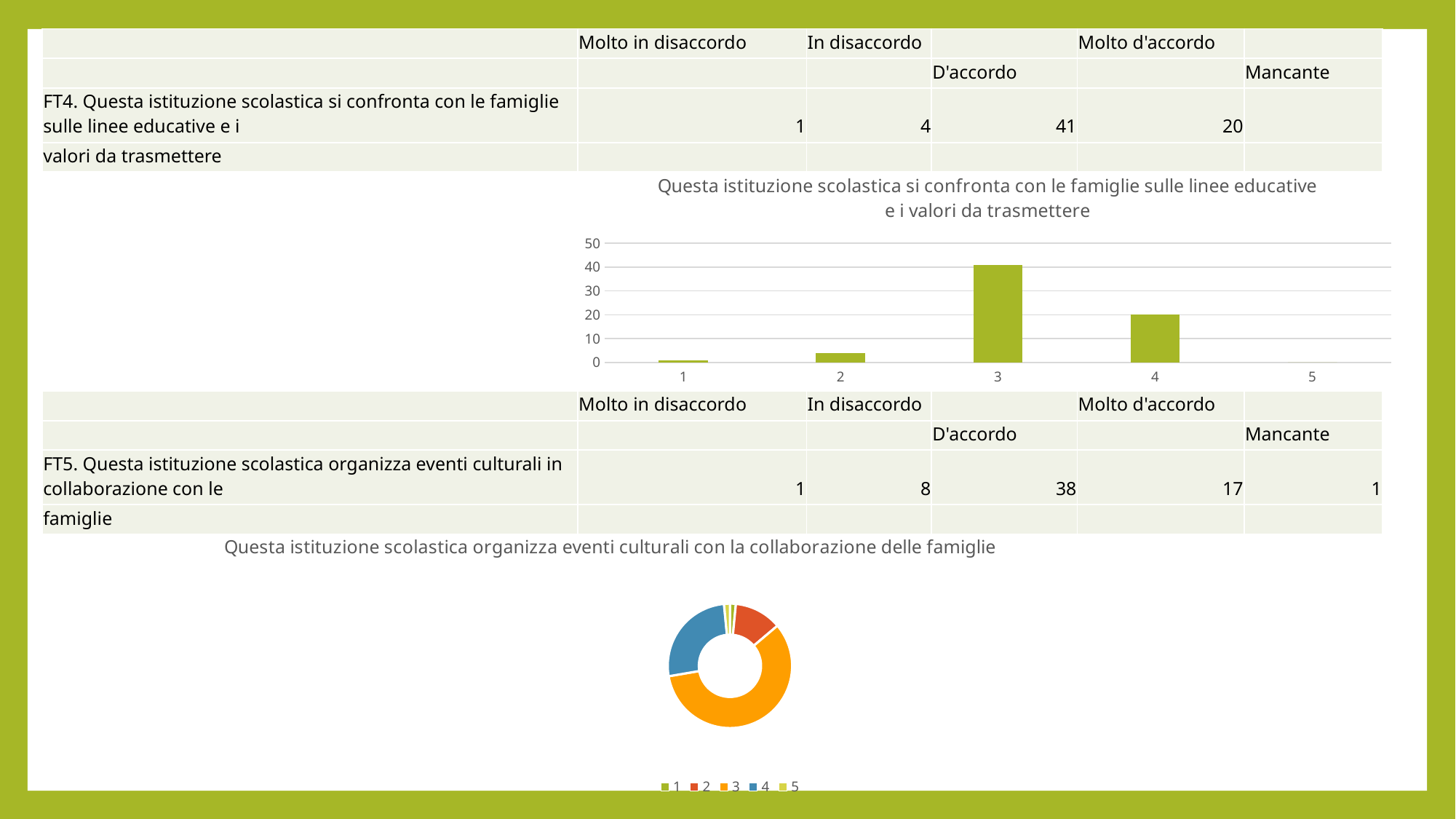
In the top bar chart, what is the highest value shown on the vertical axis? 50 In the bottom doughnut chart, how many entries does the legend list? 5 In the top bar chart, is the value for category 2 greater or less than 10? less In the bottom doughnut chart, which slice is larger, category 2 or category 4? category 4 In the top bar chart, what is the value for category 4? 20 In the top bar chart, which category has the highest bar? 3 In the top bar chart, which is larger, the bar for category 2 or the bar for category 4? category 4 In the top bar chart, how many categories are shown on the x axis? 5 In the bottom doughnut chart, which category has the largest slice? 3 What kind of chart is the bottom chart titled "Questa istituzione scolastica organizza eventi culturali con la collaborazione delle famiglie"? doughnut chart What kind of chart is the top chart titled "Questa istituzione scolastica si confronta con le famiglie sulle linee educative e i valori da trasmettere"? bar chart In the top bar chart, is the value for category 3 greater or less than 40? greater